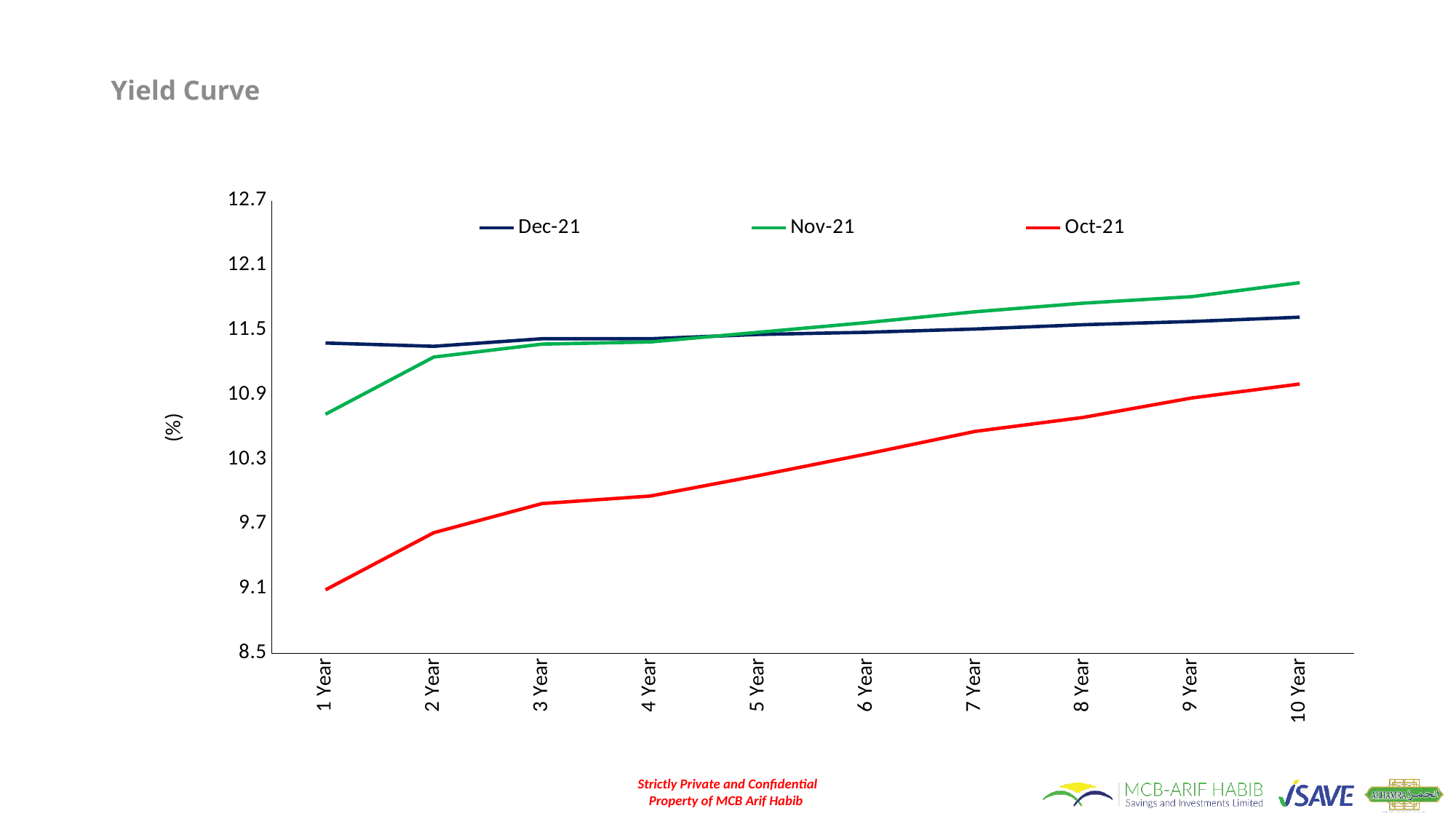
Which series has the highest value at 10 Year? Nov-21 Is the Nov-21 value at 1 Year greater or less than 10.9? less At 10 Year, which series is higher, Dec-21 or Nov-21? Nov-21 How many series does the legend list? 3 What kind of chart is shown on the slide? line chart Which series has the lowest value at 1 Year? Oct-21 Is the Oct-21 value at 5 Year greater or less than 10.3? less Does the Oct-21 line rise or fall from 1 Year to 10 Year? rise How many maturity categories are shown on the x axis? 10 At 1 Year, which series is higher, Dec-21 or Nov-21? Dec-21 What is the title of the chart? Yield Curve Is the Oct-21 value at 7 Year greater or less than 10.3? greater